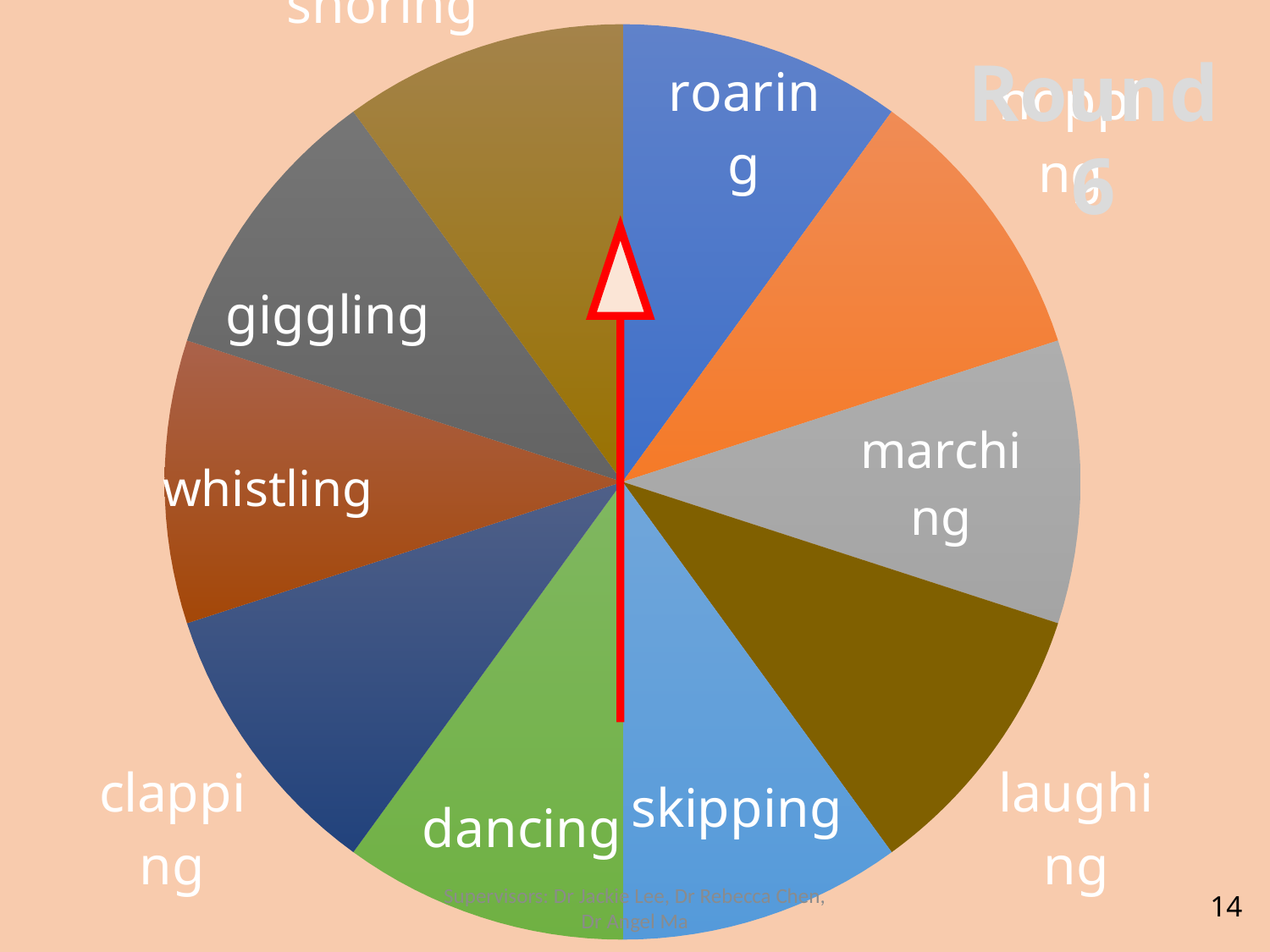
Which slice is labelled "whistling"? the brown slice on the left What colour is the slice labelled "roaring"? blue Which slice lies directly clockwise after "marching"? laughing How many slices does the pie chart have? 10 What kind of chart is shown on the slide? pie chart